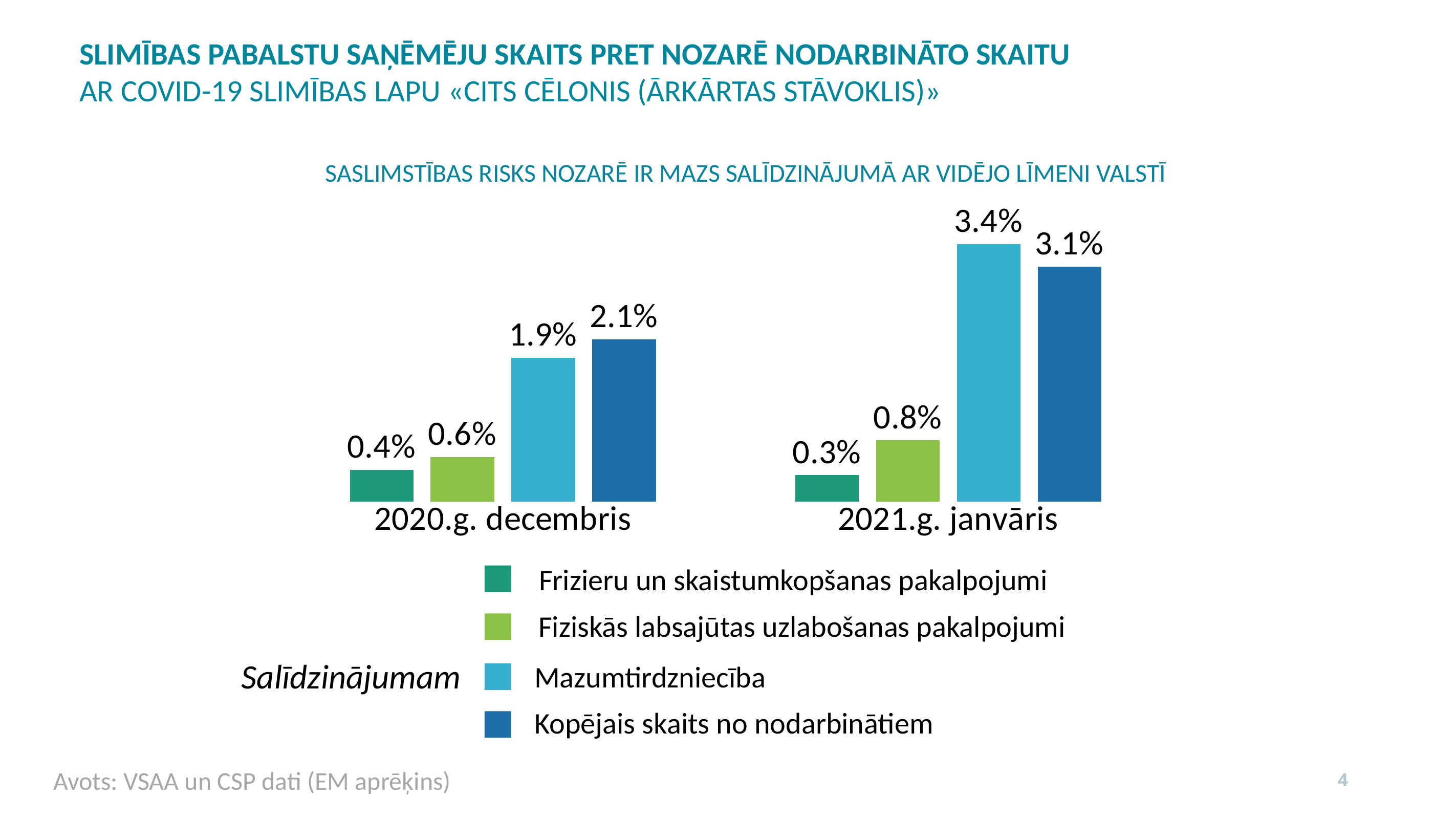
What is the value for Fiziskās labsajūtas uzlabošanas pakalpojumi in 2021.g. janvāris? 0.8% How many series does the legend list? 4 What is the value for Mazumtirdzniecība in 2021.g. janvāris? 3.4% Which series has the highest value in 2021.g. janvāris? Mazumtirdzniecība Does the value for Mazumtirdzniecība rise or fall from 2020.g. decembris to 2021.g. janvāris? Rise What is the value for Frizieru un skaistumkopšanas pakalpojumi in 2020.g. decembris? 0.4% Which series has the lowest value in 2020.g. decembris? Frizieru un skaistumkopšanas pakalpojumi Which is larger in 2020.g. decembris: Mazumtirdzniecība or Kopējais skaits no nodarbinātiem? Kopējais skaits no nodarbinātiem What is the difference between Kopējais skaits no nodarbinātiem and Frizieru un skaistumkopšanas pakalpojumi in 2021.g. janvāris? 2.8% What kind of chart is shown on the slide? Bar chart How many categories are shown on the x axis? 2 What is the value for Kopējais skaits no nodarbinātiem in 2020.g. decembris? 2.1%